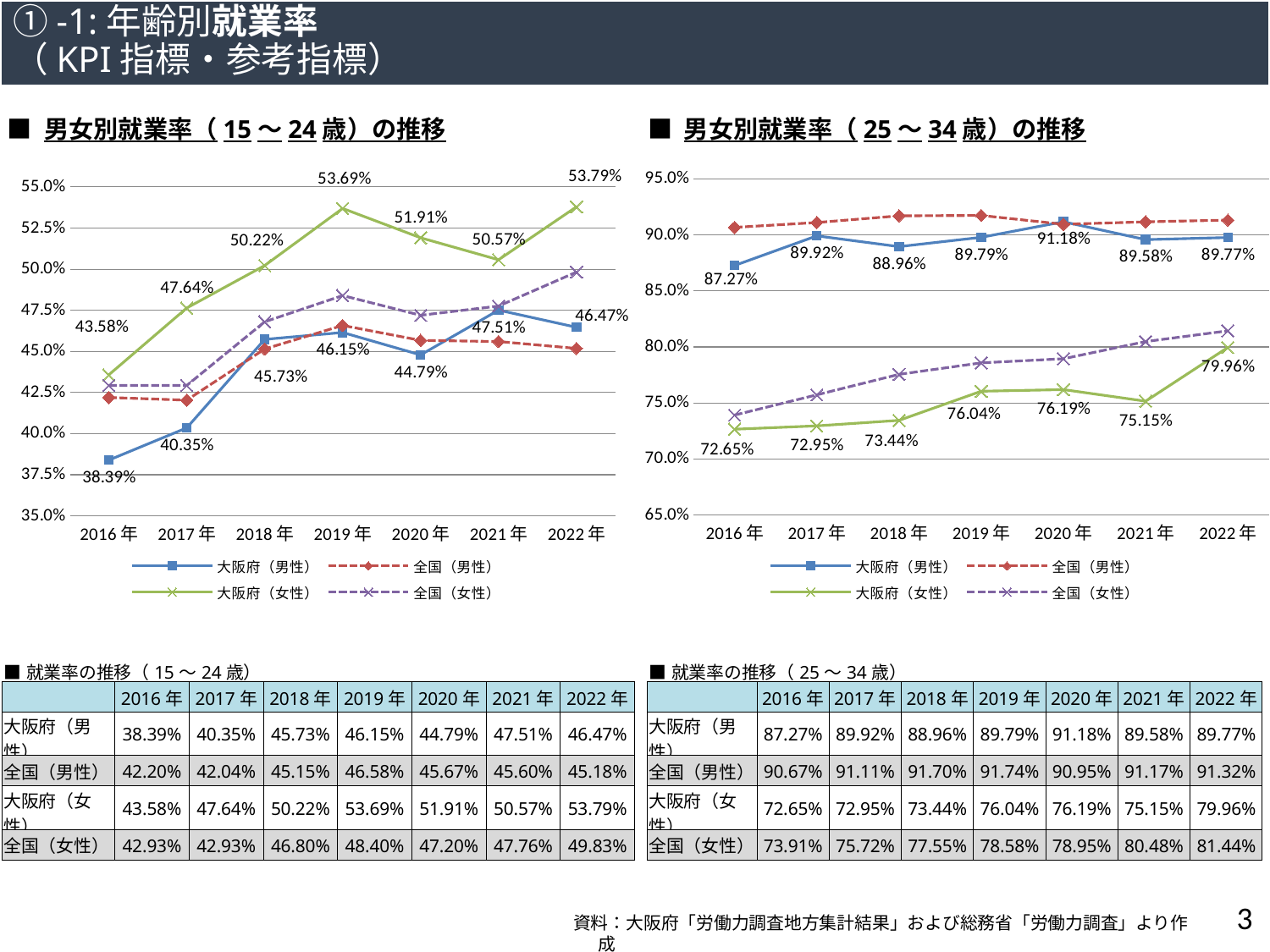
In the right chart (男女別就業率（25～34歳）の推移), which is larger in 2016年: 全国（男性） or 大阪府（男性）? 全国（男性） In the right chart (男女別就業率（25～34歳）の推移), does the value for 大阪府（女性） rise or fall from 2016年 to 2022年? rise In the right chart (男女別就業率（25～34歳）の推移), what is the value for 大阪府（女性） in 2022年? 79.96% In the right chart (男女別就業率（25～34歳）の推移), is the value for 全国（女性） in 2022年 greater or less than 80.0%? greater How many series does the legend of the left chart (男女別就業率（15～24歳）の推移) list? 4 In the right chart (男女別就業率（25～34歳）の推移), what is the value for 大阪府（男性） in 2020年? 91.18% What kind of chart is the left chart (男女別就業率（15～24歳）の推移)? line chart In the left chart (男女別就業率（15～24歳）の推移), what is the value for 大阪府（男性） in 2016年? 38.39% In the left chart (男女別就業率（15～24歳）の推移), what is the value for 大阪府（女性） in 2019年? 53.69% In the left chart (男女別就業率（15～24歳）の推移), in which year is 大阪府（男性） lowest? 2016年 In the left chart (男女別就業率（15～24歳）の推移), what is the difference between 大阪府（女性） and 大阪府（男性） in 2022年? 7.32% How many years are shown on the x axis of the right chart (男女別就業率（25～34歳）の推移)? 7